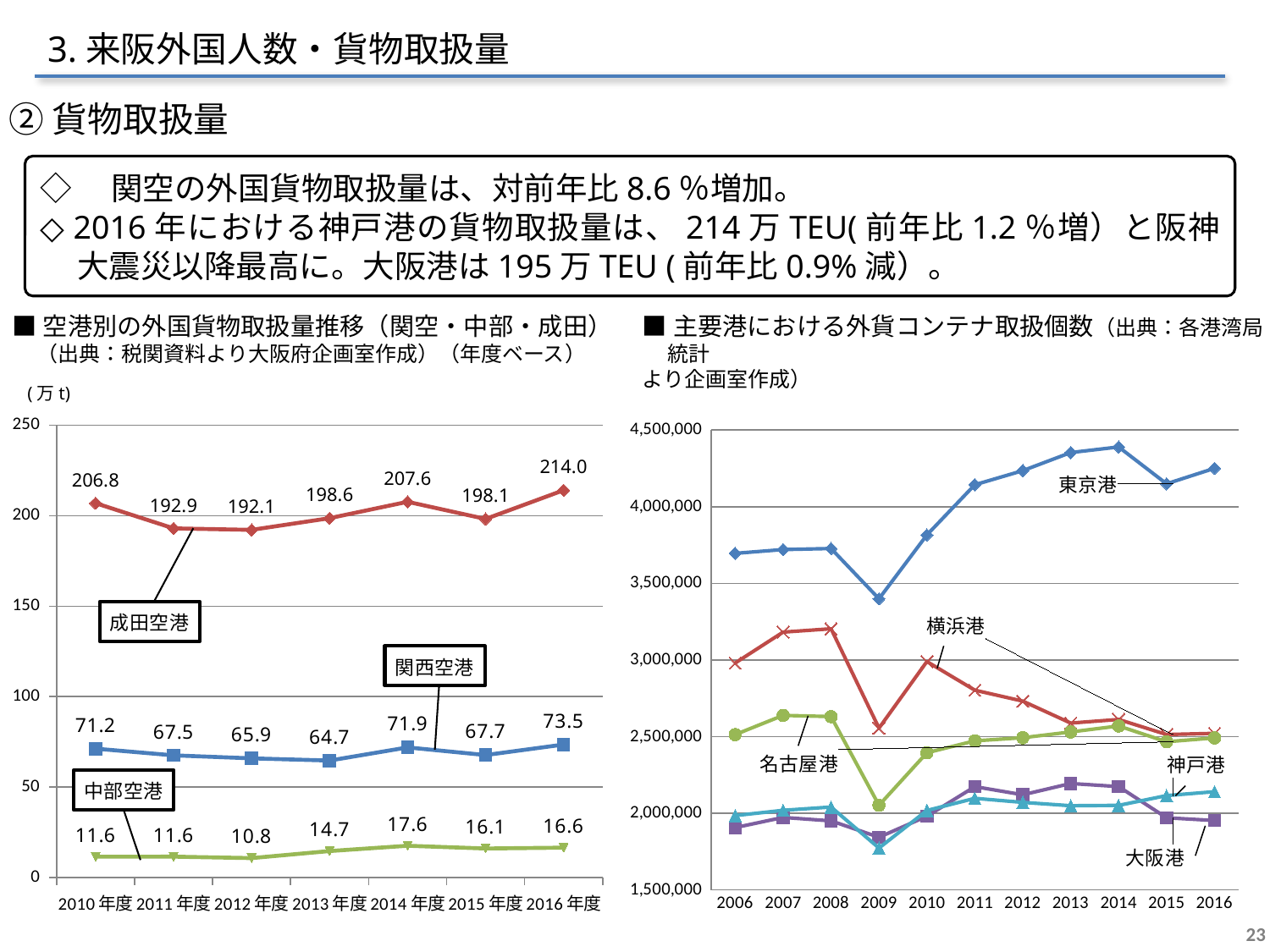
What type of chart is the right chart (主要港における外貨コンテナ取扱個数)? Line chart In the right chart (主要港における外貨コンテナ取扱個数), is the value for 横浜港 in 2008 greater or less than 3,000,000? greater In the left chart (空港別の外国貨物取扱量推移), in which fiscal year is the value for 成田空港 lowest? 2012年度 In the left chart (空港別の外国貨物取扱量推移), what is the value for 中部空港 in 2014年度? 17.6 In the left chart (空港別の外国貨物取扱量推移), what is the difference between the 関西空港 values in 2016年度 and 2015年度? 5.8 In the left chart (空港別の外国貨物取扱量推移), what is the value for 成田空港 in 2016年度? 214.0 In the left chart (空港別の外国貨物取扱量推移), in which fiscal year is the value for 関西空港 highest? 2016年度 In the left chart (空港別の外国貨物取扱量推移), what is the value for 関西空港 in 2013年度? 64.7 In the left chart (空港別の外国貨物取扱量推移), how many fiscal years are shown on the x axis? 7 In the left chart (空港別の外国貨物取扱量推移), which is larger: the 中部空港 value in 2013年度 or in 2015年度? 2015年度 In the right chart (主要港における外貨コンテナ取扱個数), which port has the highest values across all years? 東京港 In the right chart (主要港における外貨コンテナ取扱個数), is the value for 東京港 in 2009 greater or less than 3,500,000? less